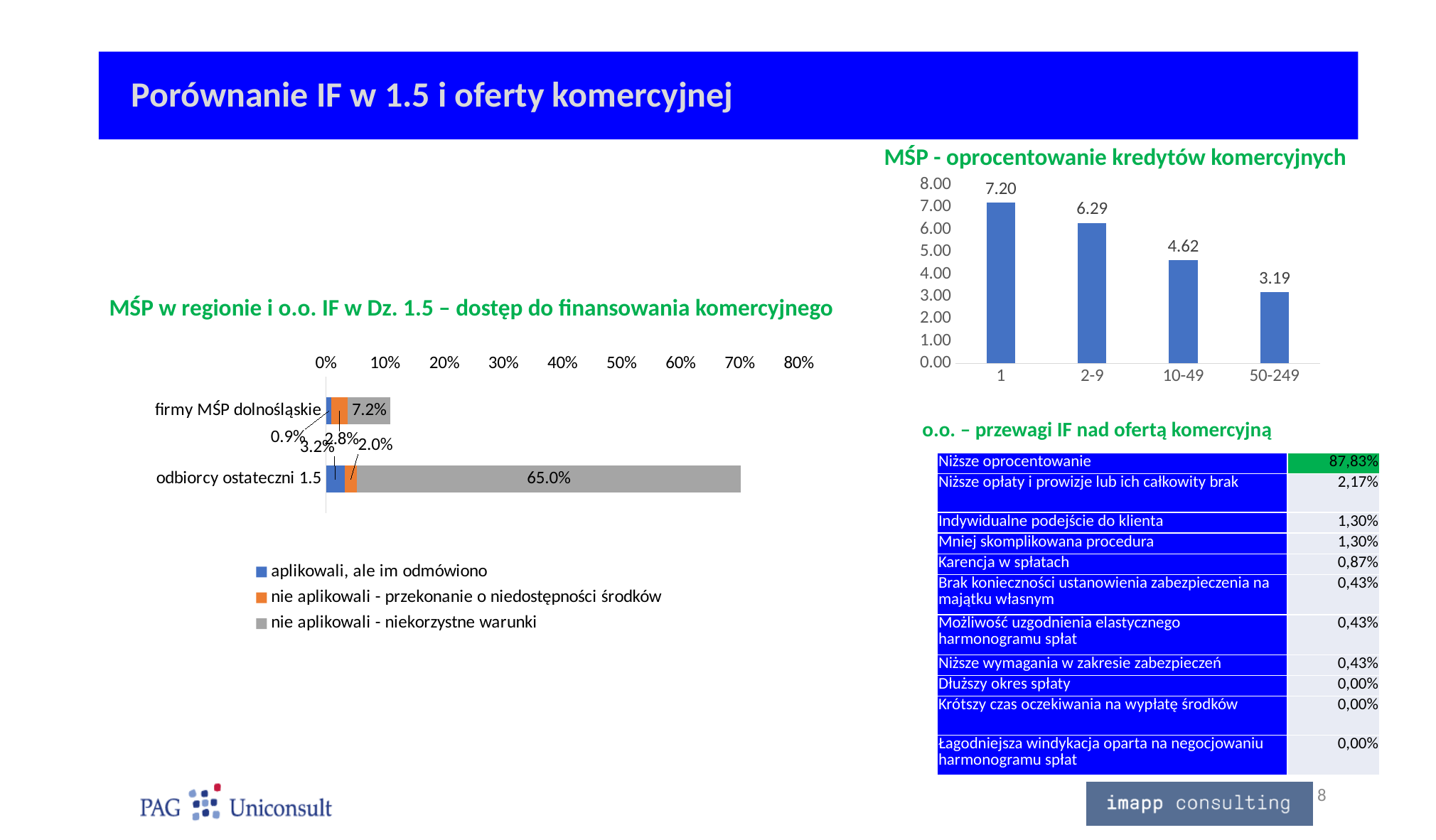
In the chart titled 'MŚP - oprocentowanie kredytów komercyjnych', which category has the lowest value? 50-249 What kind of chart is the one titled 'MŚP w regionie i o.o. IF w Dz. 1.5 – dostęp do finansowania komercyjnego'? stacked bar chart In the chart titled 'MŚP w regionie i o.o. IF w Dz. 1.5 – dostęp do finansowania komercyjnego', what is the total of the stacked bar for 'odbiorcy ostateczni 1.5'? 70.2% In the chart titled 'MŚP - oprocentowanie kredytów komercyjnych', how many categories are shown on the x axis? 4 In the chart titled 'MŚP - oprocentowanie kredytów komercyjnych', what is the value for the category '1'? 7.20 In the chart titled 'MŚP w regionie i o.o. IF w Dz. 1.5 – dostęp do finansowania komercyjnego', how many series does the legend list? 3 In the chart titled 'MŚP - oprocentowanie kredytów komercyjnych', what is the difference between the values for '2-9' and '50-249'? 3.10 In the chart titled 'MŚP - oprocentowanie kredytów komercyjnych', what is the value for the category '10-49'? 4.62 In the chart titled 'MŚP - oprocentowanie kredytów komercyjnych', do the values rise or fall from left to right along the x axis? fall In the chart titled 'MŚP - oprocentowanie kredytów komercyjnych', which category has the highest value? 1 In the chart titled 'MŚP w regionie i o.o. IF w Dz. 1.5 – dostęp do finansowania komercyjnego', what is the value of 'nie aplikowali - niekorzystne warunki' for 'firmy MŚP dolnośląskie'? 7.2% In the chart titled 'MŚP w regionie i o.o. IF w Dz. 1.5 – dostęp do finansowania komercyjnego', what is the value of 'nie aplikowali - niekorzystne warunki' for 'odbiorcy ostateczni 1.5'? 65.0%